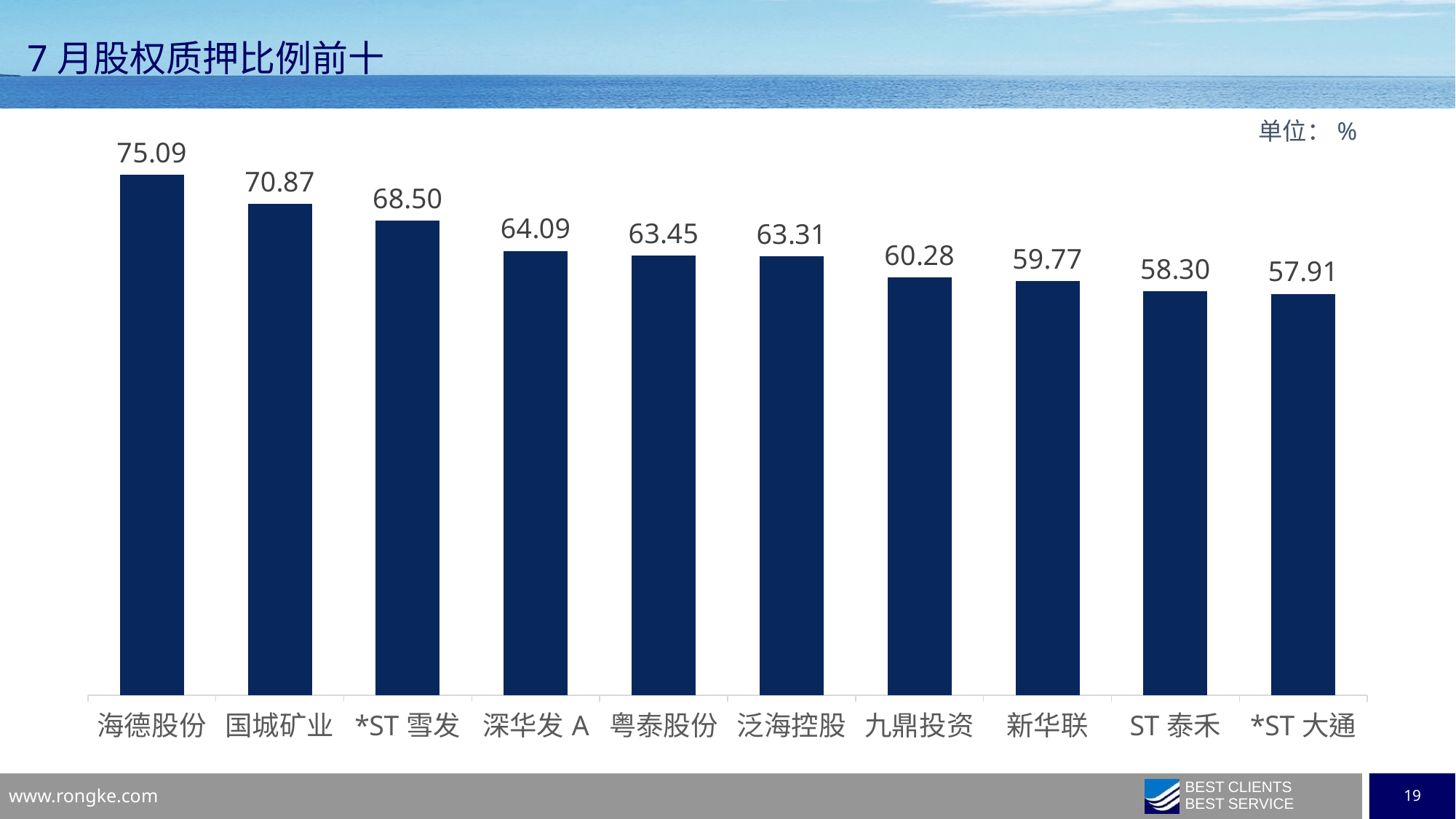
What is the difference between the values for 海德股份 and 国城矿业? 4.22 What is the value for 泛海控股? 63.31 Which category has the highest value? 海德股份 What is the title of the chart? 7 月股权质押比例前十 What kind of chart is shown on the slide? Bar chart What is the difference between the values for 深华发 A and 九鼎投资? 3.81 What is the value for 海德股份? 75.09 Do the values rise or fall from left to right along the x axis? Fall Which category has the lowest value? *ST 大通 Which is larger, the value for *ST 雪发 or the value for 新华联? *ST 雪发 How many categories are shown in the chart? 10 What is the value for ST 泰禾? 58.30